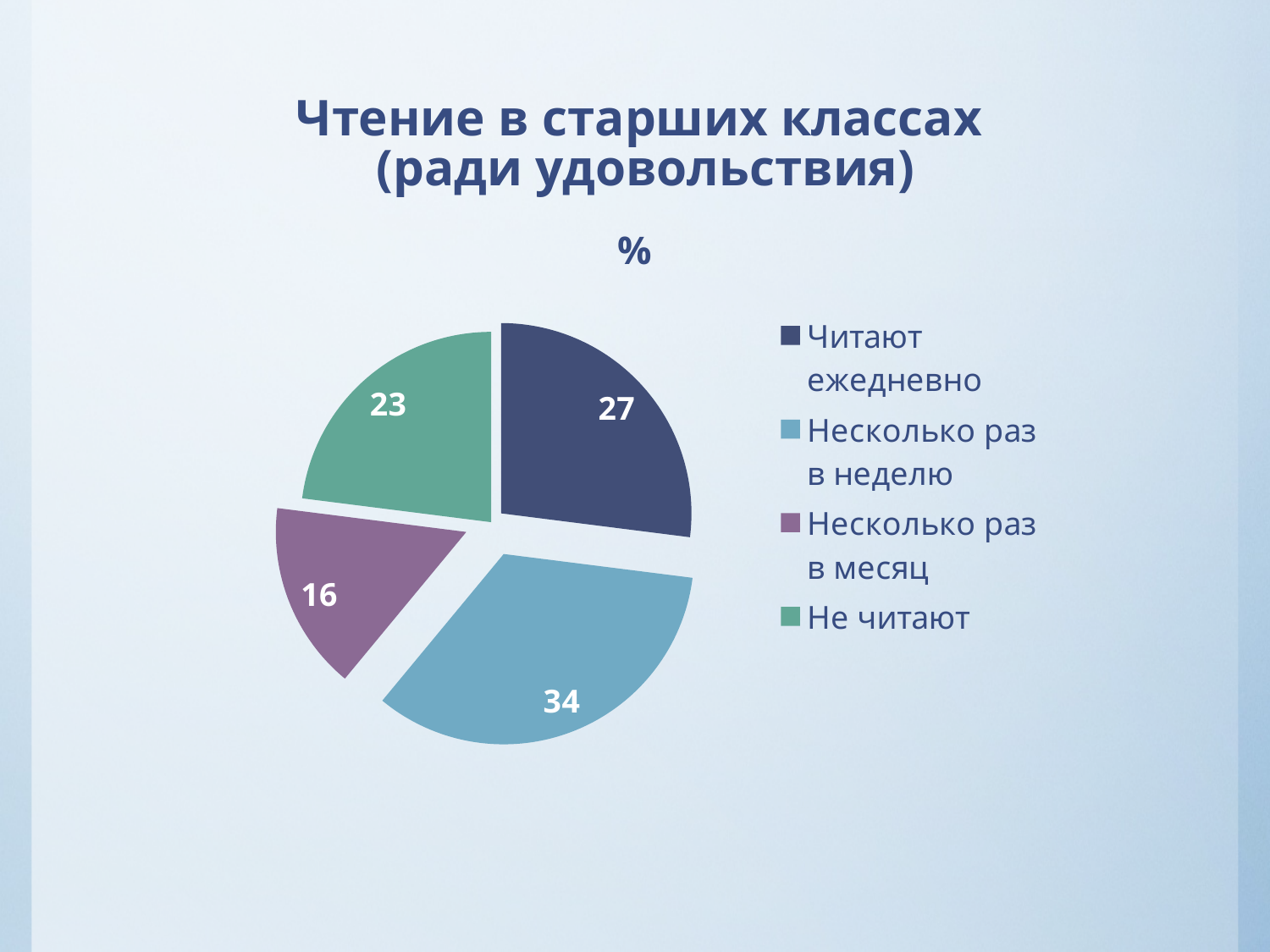
What is the title of the chart? % What is the value for "Несколько раз в месяц"? 16 Which category has the largest slice? Несколько раз в неделю What colour is the slice for "Не читают"? green What is the value for "Несколько раз в неделю"? 34 What is the difference between the values for "Несколько раз в неделю" and "Несколько раз в месяц"? 18 Which is larger: the value for "Читают ежедневно" or the value for "Не читают"? Читают ежедневно What is the value for "Читают ежедневно"? 27 Which category has the smallest slice? Несколько раз в месяц What is the value for "Не читают"? 23 What kind of chart is shown on the slide? pie chart How many slices does the pie chart have? 4